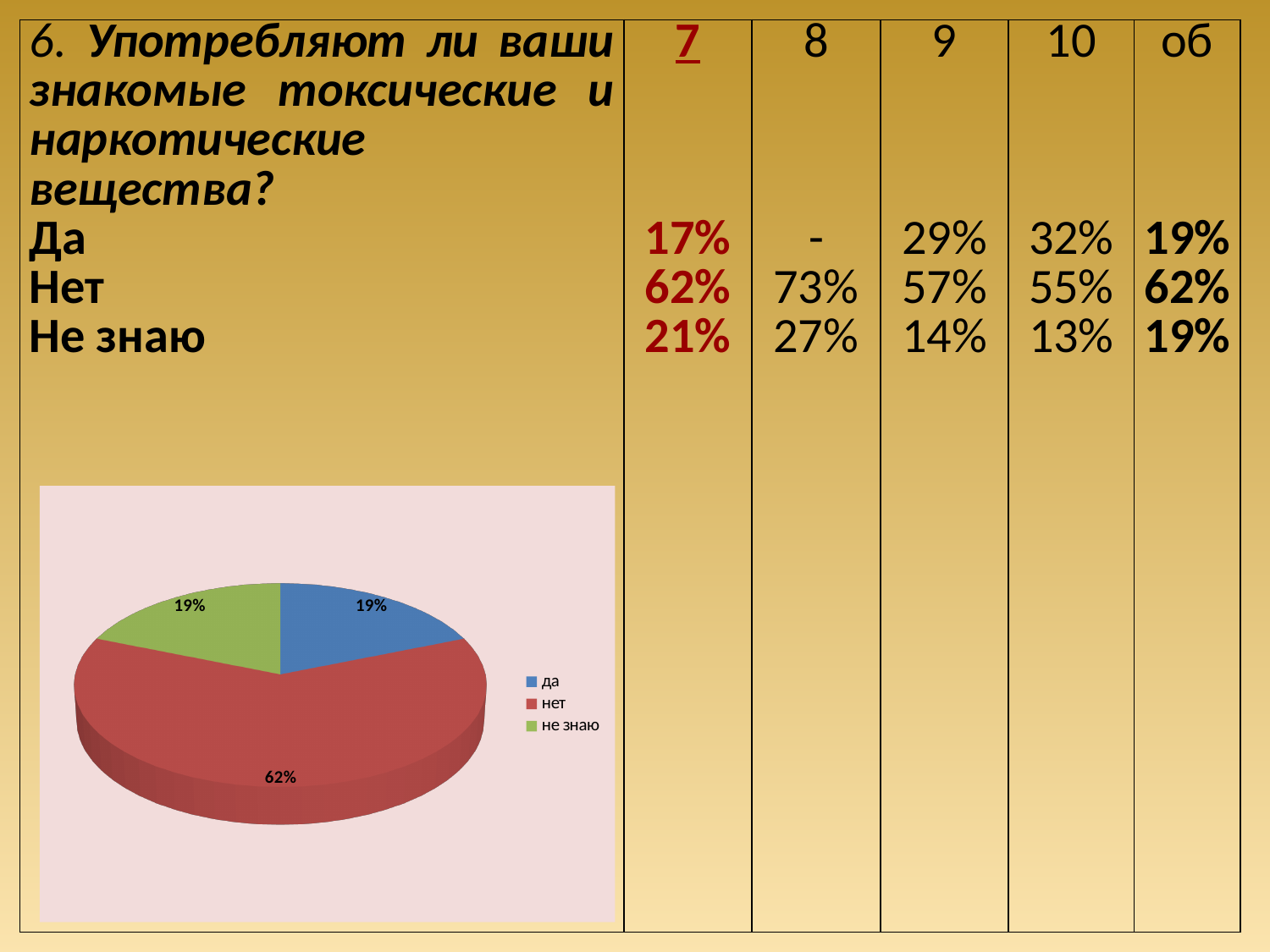
What share of the pie does the "нет" slice represent? 62% What colour is the "нет" slice in the pie chart? red How many entries does the legend of the pie chart list? 3 Which is larger in the pie chart, the "нет" slice or the "не знаю" slice? нет What type of chart is shown on the slide? pie chart Which slice of the pie chart is the largest? нет How many slices does the pie chart have? 3 What share of the pie does the "не знаю" slice represent? 19% What share of the pie does the "да" slice represent? 19% What is the difference between the "нет" slice and the "да" slice in the pie chart? 43% What colour is the "не знаю" slice in the pie chart? green